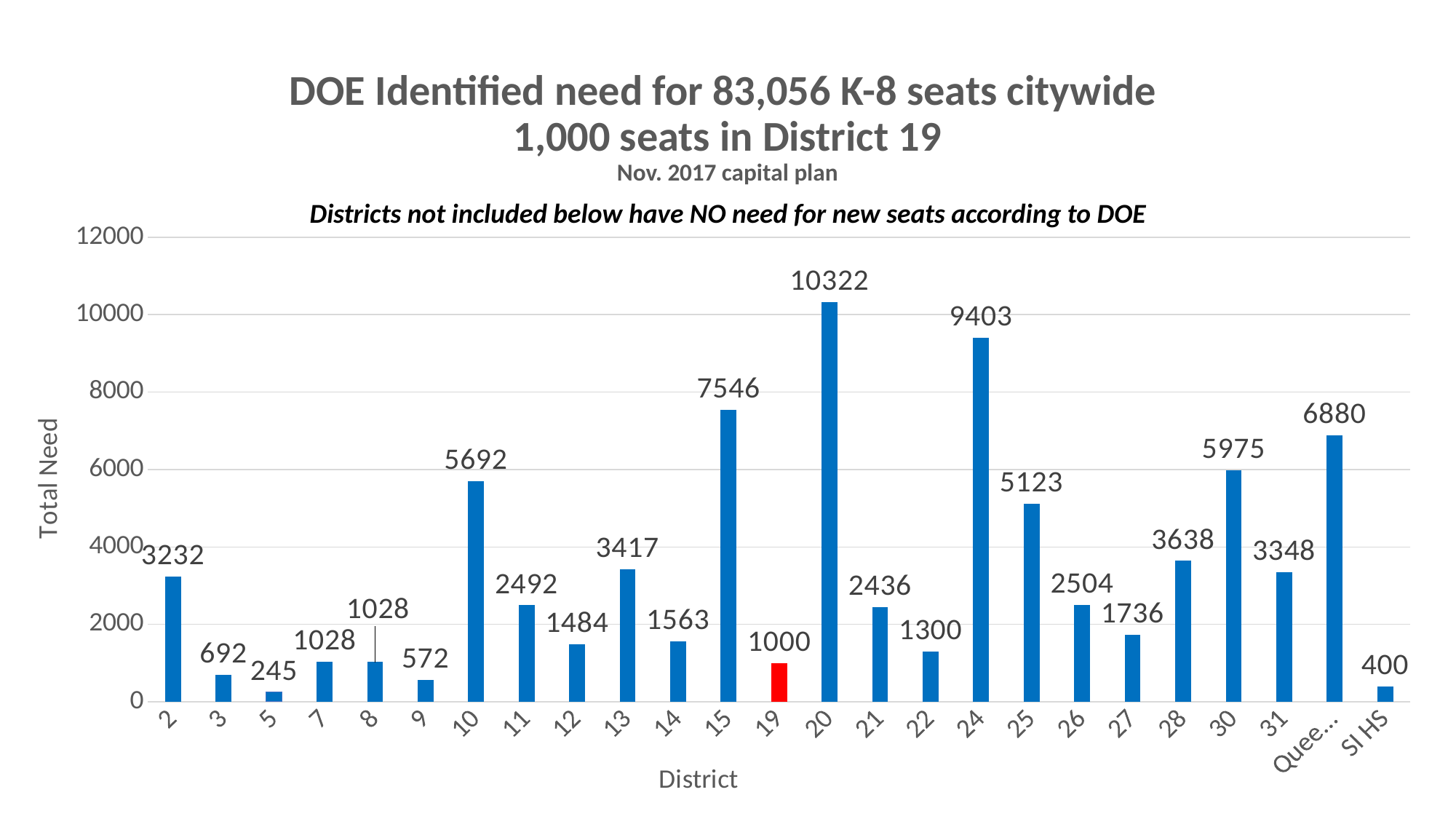
What is the total need for SI HS? 400 How many districts (categories) are shown on the x axis? 25 Which district has the lowest total need? 5 Which has a larger total need, District 10 or District 30? District 30 What is the total need for District 24? 9403 What is the total need for District 20? 10322 What kind of chart is shown on the slide? Bar chart Which district's bar is coloured red instead of blue? 19 Which district has the highest total need? 20 What is the difference in total need between District 15 and District 19? 6546 What is the total need for District 19? 1000 What is the difference in total need between District 20 and District 24? 919